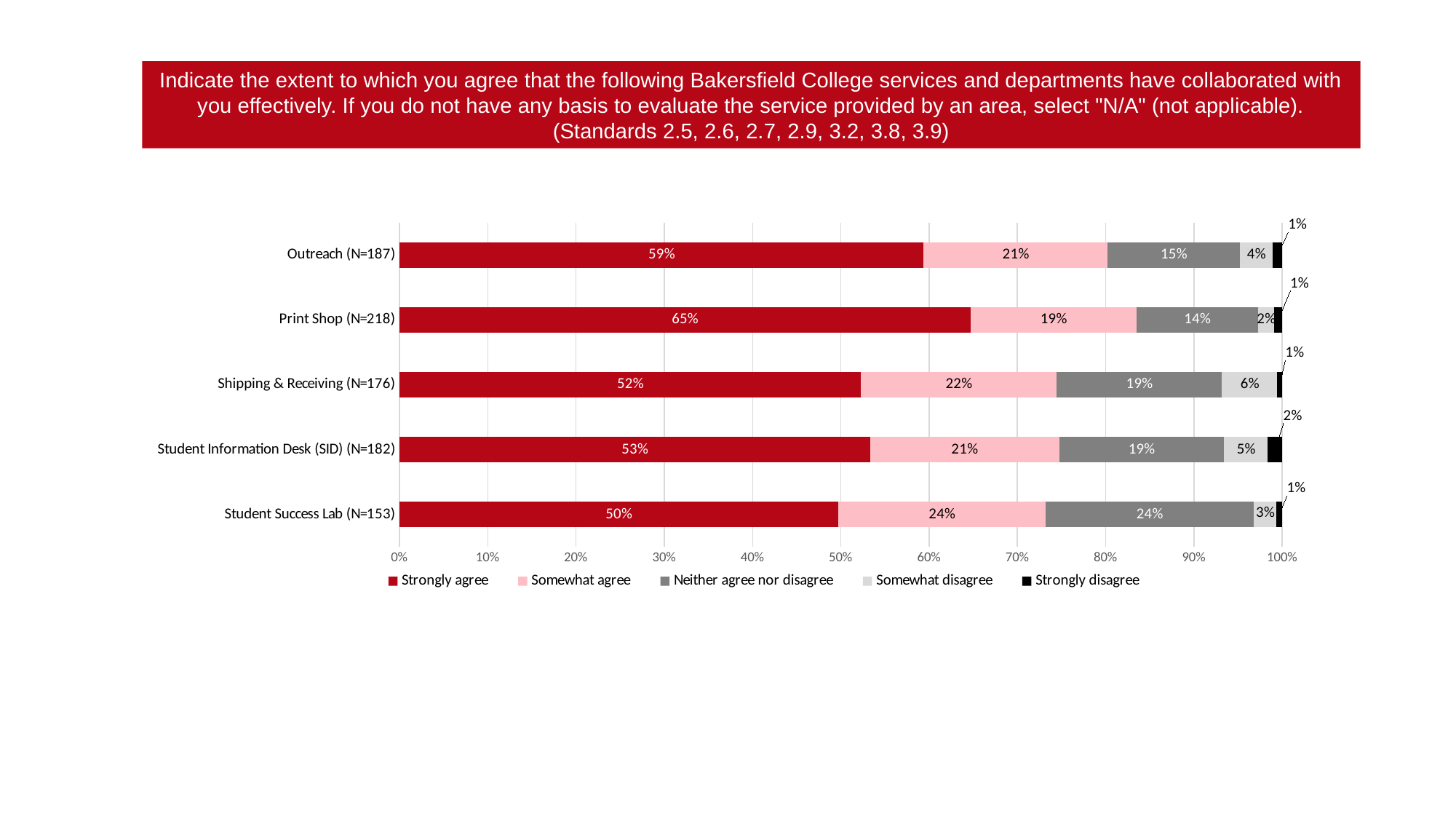
How many departments are shown in the chart? 5 Which department has the highest Somewhat disagree percentage? Shipping & Receiving (N=176) Which has a larger Neither agree nor disagree percentage, Student Success Lab (N=153) or Outreach (N=187)? Student Success Lab (N=153) Which department has the lowest Strongly agree percentage? Student Success Lab (N=153) What is the difference in Strongly agree percentage between Print Shop (N=218) and Outreach (N=187)? 6 percentage points What is the Strongly disagree value for Student Information Desk (SID) (N=182)? 2% Which department has the highest Strongly agree percentage? Print Shop (N=218) What is the Somewhat agree value for Student Success Lab (N=153)? 24% What percentage of respondents strongly agree for Print Shop (N=218)? 65% What type of chart is shown on the slide? Stacked bar chart What is the Somewhat disagree value for Shipping & Receiving (N=176)? 6% How many response categories does the legend list? 5